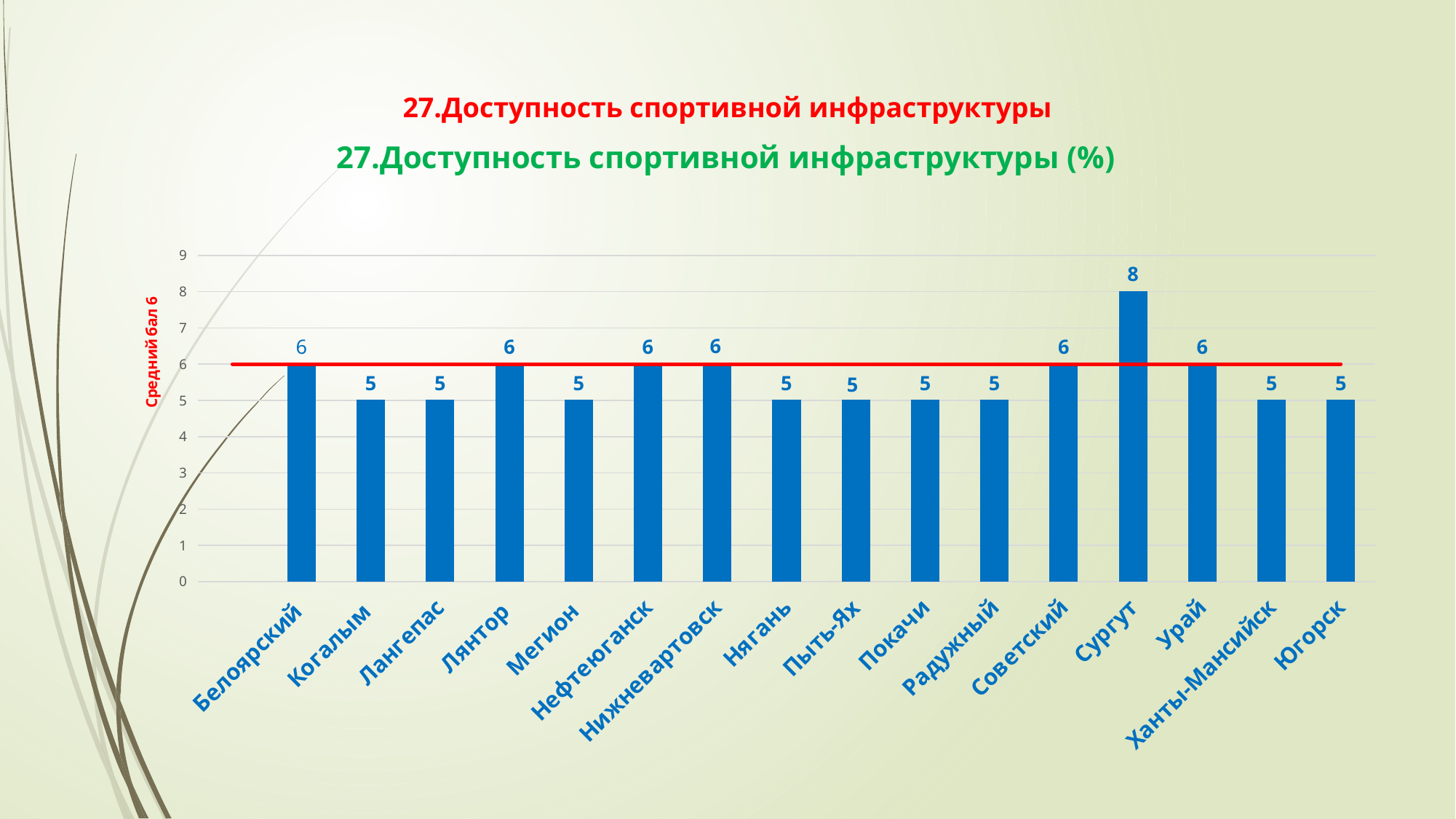
Which is larger, the value for Сургут or the value for Урай? Сургут What value does the red horizontal line labelled 'Средний бал' mark? 6 What is the value for Ханты-Мансийск? 5 What is the value for Сургут? 8 What is the value for Нижневартовск? 6 What is the difference between the values for Сургут and Когалым? 3 What is the difference between the values for Лянтор and Мегион? 1 Is the value for Сургут greater or less than 7? greater Which category has the highest value? Сургут How many categories are shown on the x axis? 16 What is the value for Когалым? 5 What kind of chart is shown on the slide? combination bar and line chart